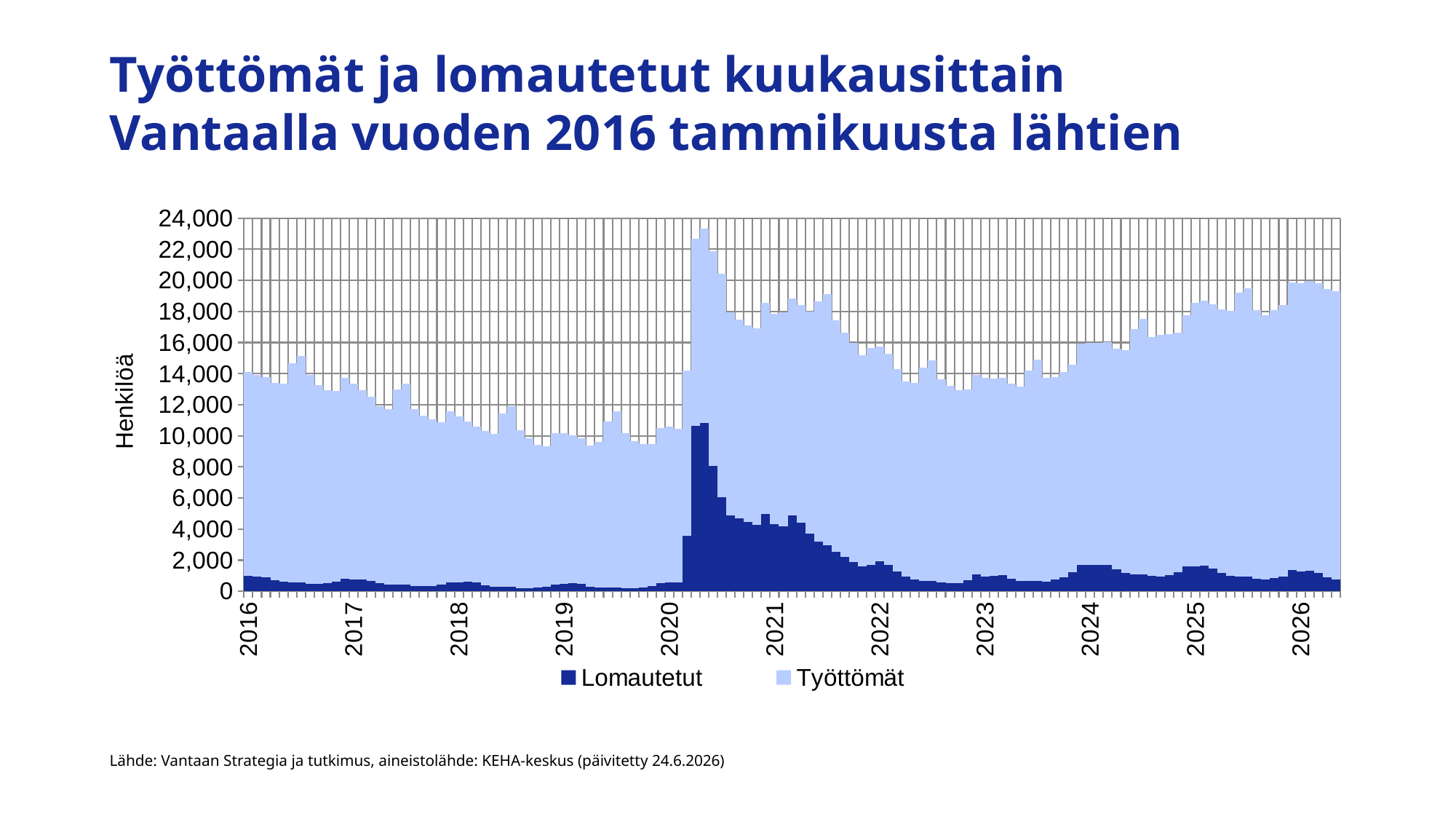
What are the two series named in the legend? Lomautetut and Työttömät Is the total value at the start of 2026 greater or less than 18,000? greater How many series does the legend list? 2 Is the peak value of Lomautetut in 2020 greater or less than 10,000? greater Does the total of Työttömät and Lomautetut rise or fall from 2016 to 2019? fall In which year does the Lomautetut series reach its highest value? 2020 Is the peak total value in 2020 greater or less than 22,000? greater In which year does the total of Lomautetut and Työttömät reach its highest peak? 2020 What kind of chart is shown on the slide? Stacked bar chart How many year labels are shown on the horizontal axis? 11 What is the label on the vertical axis? Henkilöä